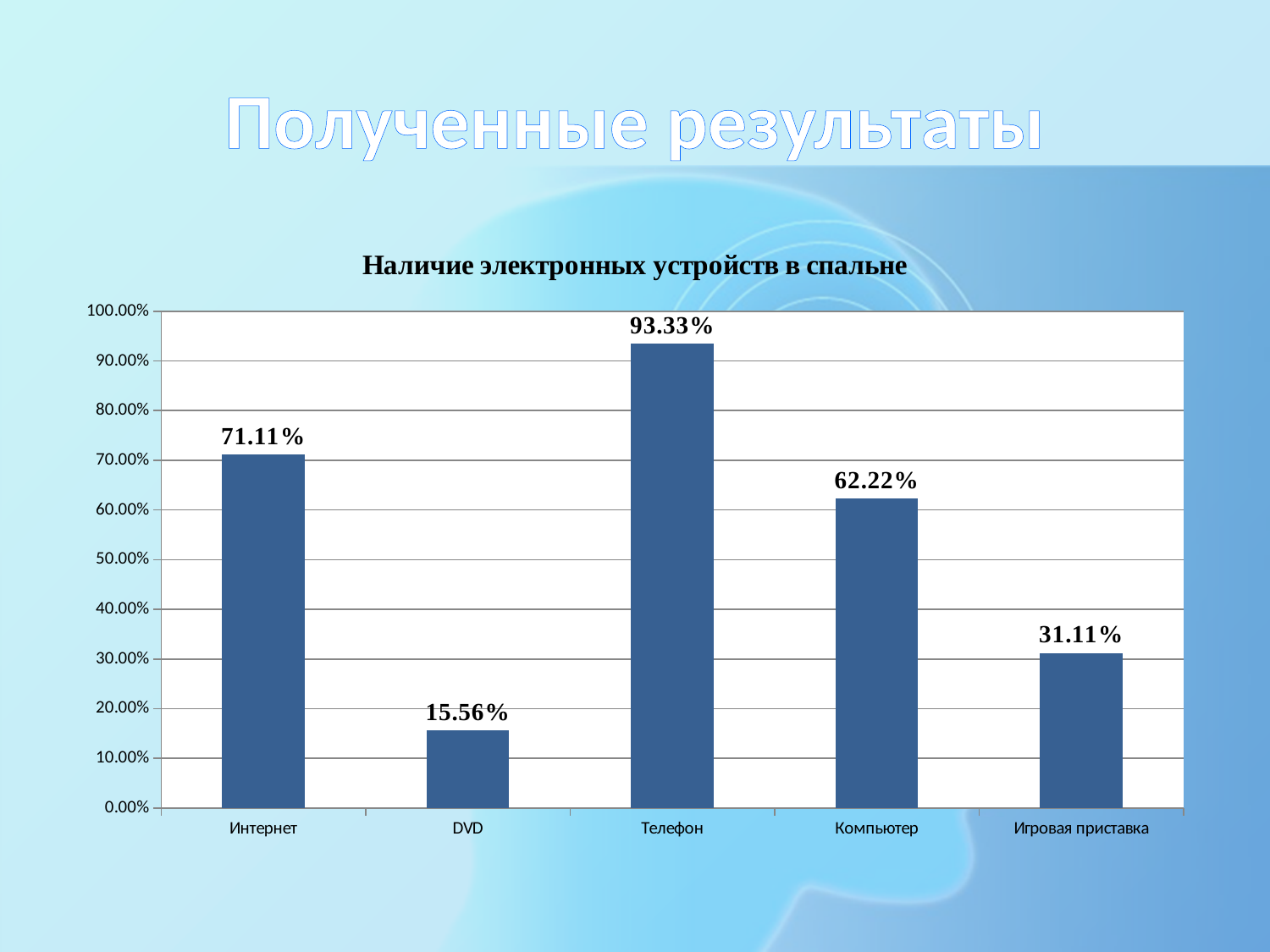
Which category has the lowest value? DVD What is the title of the chart? Наличие электронных устройств в спальне What is the difference between the values for Интернет and Компьютер? 8.89% Which is larger, the value for Интернет or the value for Компьютер? Интернет How many categories are shown on the x axis? 5 Which category has the highest value? Телефон What kind of chart is shown on the slide? bar chart What is the value for DVD? 15.56% What is the value for Телефон? 93.33% What is the value for Игровая приставка? 31.11% What is the difference between the values for Телефон and DVD? 77.77% Is the value for Компьютер greater or less than 50.00%? greater